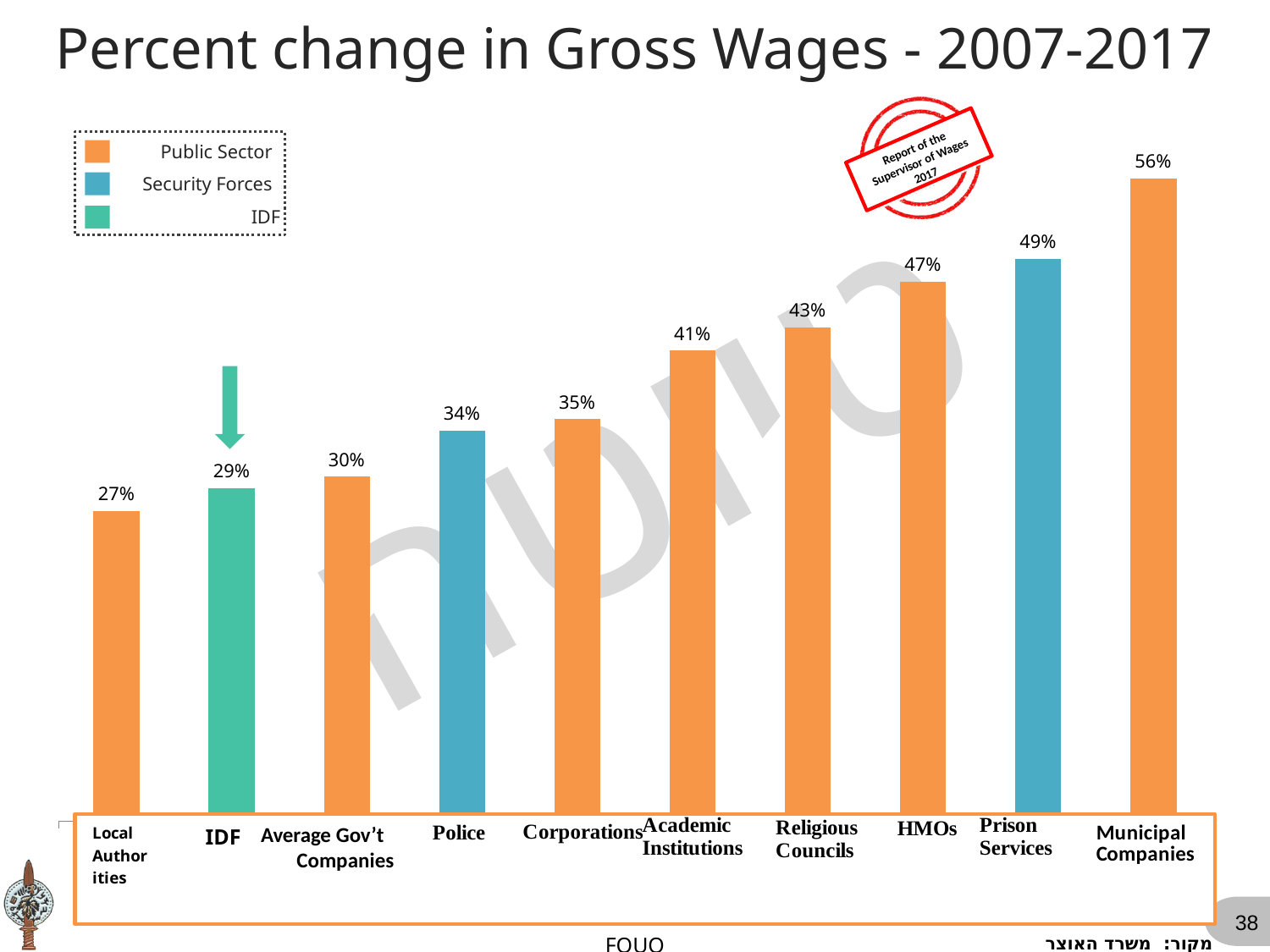
Which category has the lowest percent change in gross wages? Local Authorities What is the percent change in gross wages for the IDF? 29% Which category has the highest percent change in gross wages? Municipal Companies What kind of chart is shown on the slide? Bar chart What is the difference between the percent change for Municipal Companies and for Local Authorities? 29% What is the difference between the percent change for Prison Services and for Police? 15% What is the percent change in gross wages for HMOs? 47% Do the values rise or fall from left to right across the categories? Rise How many categories are shown in the chart? 10 Which has a larger percent change in gross wages, Religious Councils or Academic Institutions? Religious Councils How many entries does the legend list? 3 What is the percent change in gross wages for Police? 34%